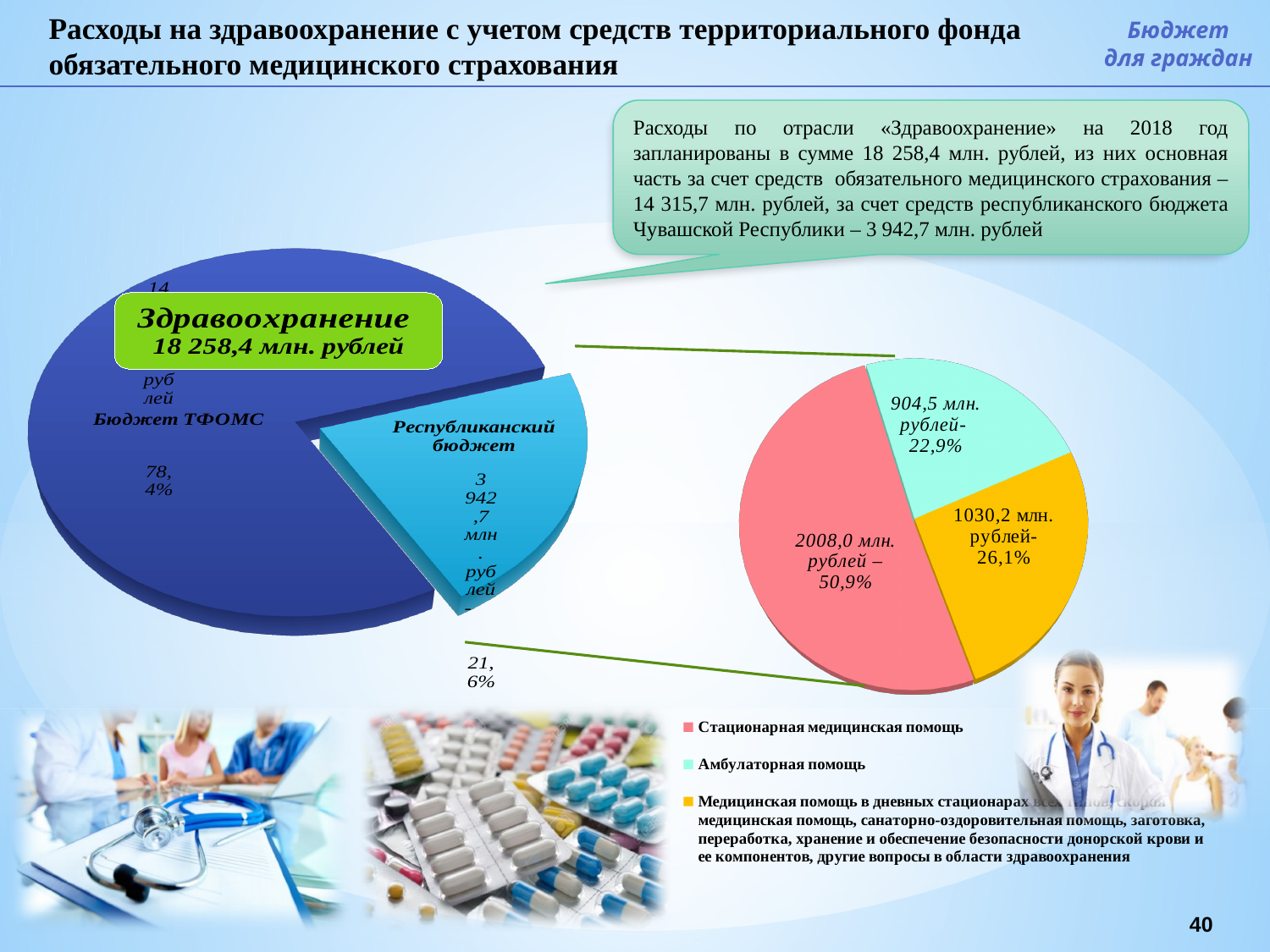
In the left pie chart, what share is shown for Бюджет ТФОМС? 78,4% In the right pie chart, which category has the smallest slice? Амбулаторная помощь In the left pie chart, what share is shown for Республиканский бюджет? 21,6% In the right pie chart, what amount is shown for the yellow slice (Медицинская помощь в дневных стационарах ...)? 1030,2 млн. рублей What total amount is shown in the green label on the left pie chart for Здравоохранение? 18 258,4 млн. рублей In the left pie chart, which slice is larger: Бюджет ТФОМС or Республиканский бюджет? Бюджет ТФОМС What kind of chart is the left chart on the slide? pie chart In the right pie chart, what amount is shown for Стационарная медицинская помощь? 2008,0 млн. рублей In the left pie chart, what amount in млн. рублей is shown for Республиканский бюджет? 3 942,7 млн. рублей In the right pie chart, what share is shown for Амбулаторная помощь? 22,9% How many entries does the legend of the right pie chart list? 3 In the right pie chart, which category has the largest slice? Стационарная медицинская помощь